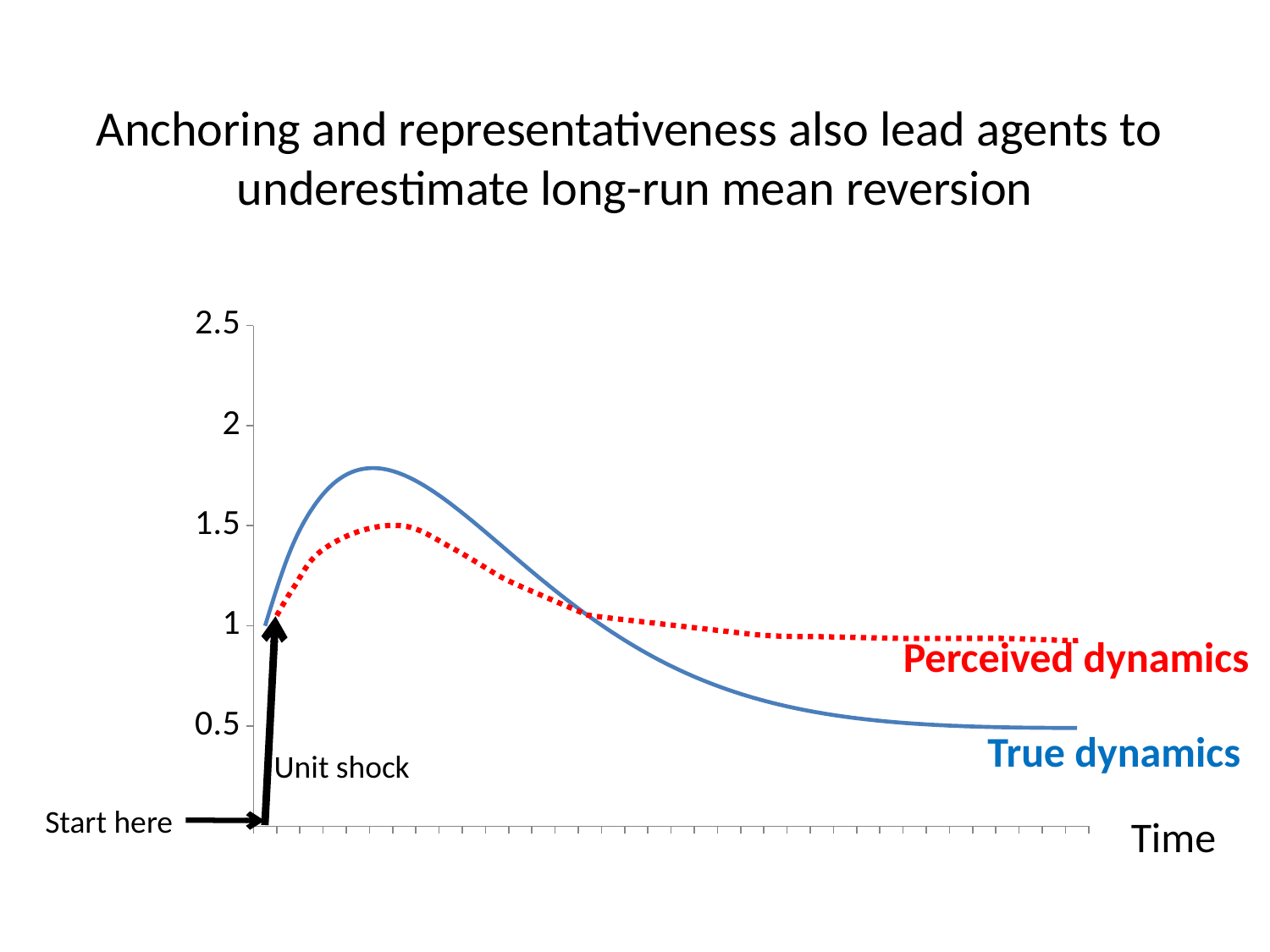
What kind of chart is shown on the slide? line chart At what value on the vertical axis do both series start after the unit shock? 1 What is the label on the horizontal axis of the chart? Time What colour is the line for the True dynamics series? blue Is the value of the True dynamics series at the right-hand end of the chart greater or less than 1? less Is the peak value of the True dynamics series greater or less than 1.5? greater Is the peak value of the Perceived dynamics series greater or less than 2? less Which series reaches the higher peak, True dynamics or Perceived dynamics? True dynamics How many series are plotted on the chart? 2 Which series is higher at the right-hand end of the chart, True dynamics or Perceived dynamics? Perceived dynamics After reaching its peak, does the True dynamics series rise or fall as time increases? fall